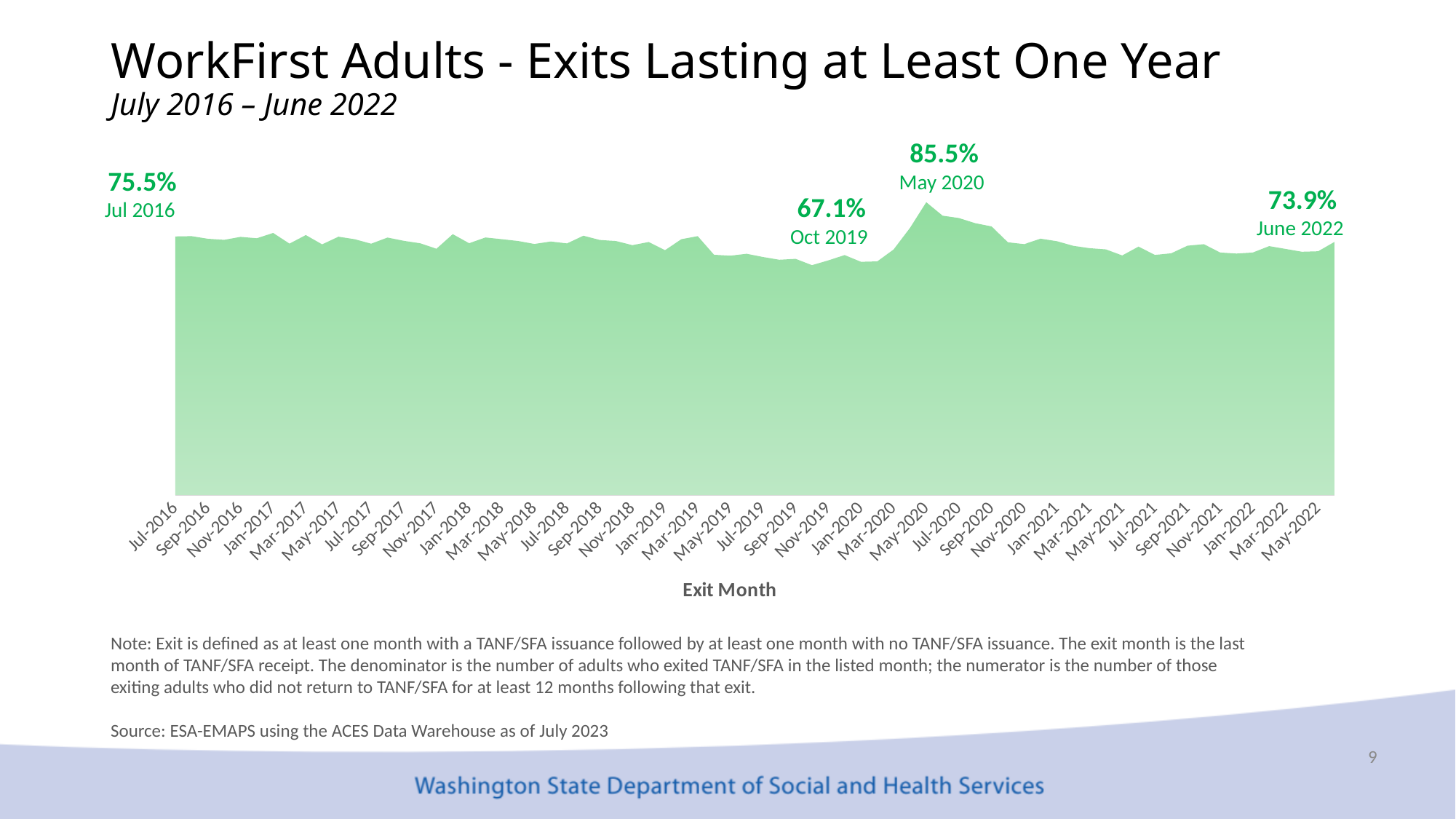
Which is larger, the value for Jul 2016 or the value for June 2022? Jul 2016 What is the difference between the May 2020 value and the Oct 2019 value? 18.4 percentage points What is the title of the x axis? Exit Month Which of the labeled months has the lowest value? Oct 2019 What is the value labeled for Oct 2019? 67.1% What is the value labeled for June 2022? 73.9% What kind of chart is shown on the slide? area chart What is the difference between the Jul 2016 value and the June 2022 value? 1.6 percentage points Does the value rise or fall from Oct 2019 to May 2020? rise What is the value labeled for May 2020? 85.5% What is the value labeled for Jul 2016? 75.5% Which month has the highest value on the chart? May 2020